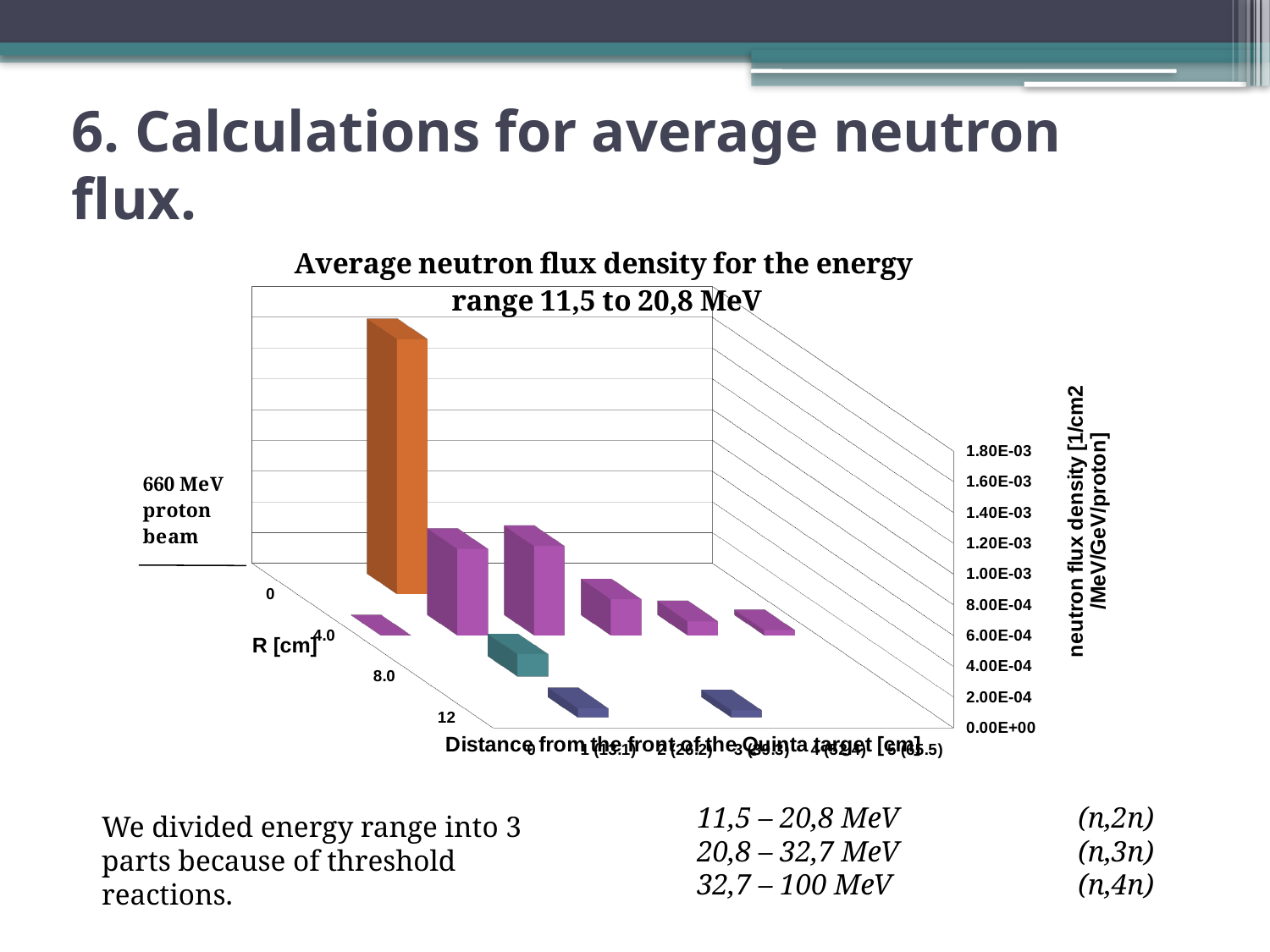
How many distance categories are shown along the chart's horizontal axis? 6 Is the value of the bar at R = 8.0, distance 1 (13.1) greater or less than 1.00E-03? less At which distance category does the tallest bar on the chart appear? 1 (13.1) What is the highest tick value shown on the vertical axis? 1.80E-03 At which R [cm] value does the tallest bar on the chart appear? 0 What kind of chart is shown on the slide? 3D bar chart What is the title of the chart? Average neutron flux density for the energy range 11,5 to 20,8 MeV How many R [cm] categories are shown on the chart's depth axis? 4 What is the label of the vertical axis of the chart? neutron flux density [1/cm2 /MeV/GeV/proton]